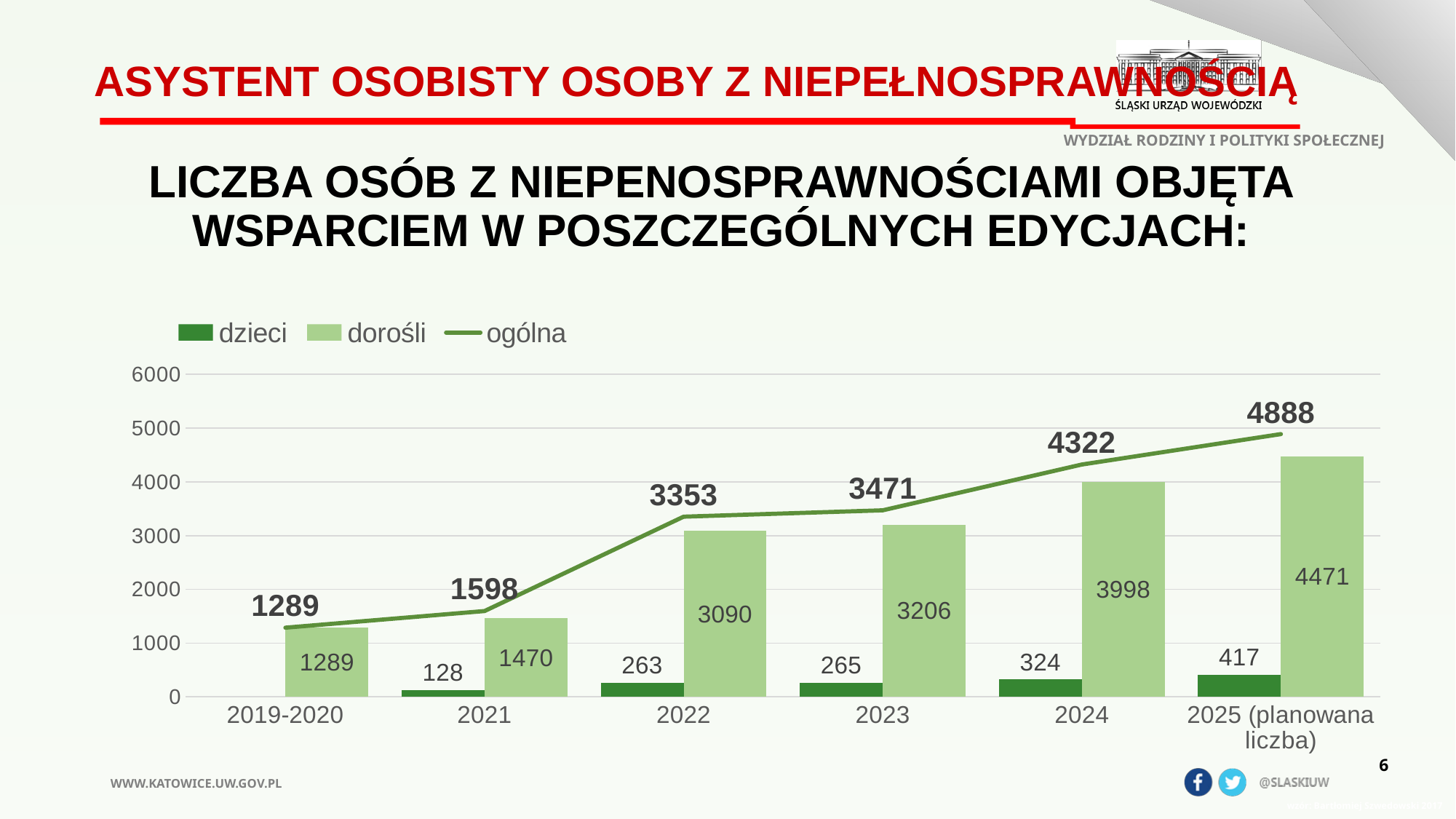
Which series is drawn as a line rather than bars? ogólna Which is larger, the 'dzieci' value for 2022 or for 2023? 2023 What is the 'dzieci' value for 2021? 128 How many series does the legend list? 3 How many categories are shown on the x axis? 6 Which category has the lowest 'ogólna' value? 2019-2020 Which category has the highest 'dorośli' value? 2025 (planowana liczba) What is the 'ogólna' value for 2025 (planowana liczba)? 4888 What is the difference between the 'ogólna' values for 2024 and 2023? 851 What is the 'dorośli' value for 2024? 3998 What is the value of the 'ogólna' line for 2022? 3353 Does the 'ogólna' line rise or fall from 2019-2020 to 2025 (planowana liczba)? rise